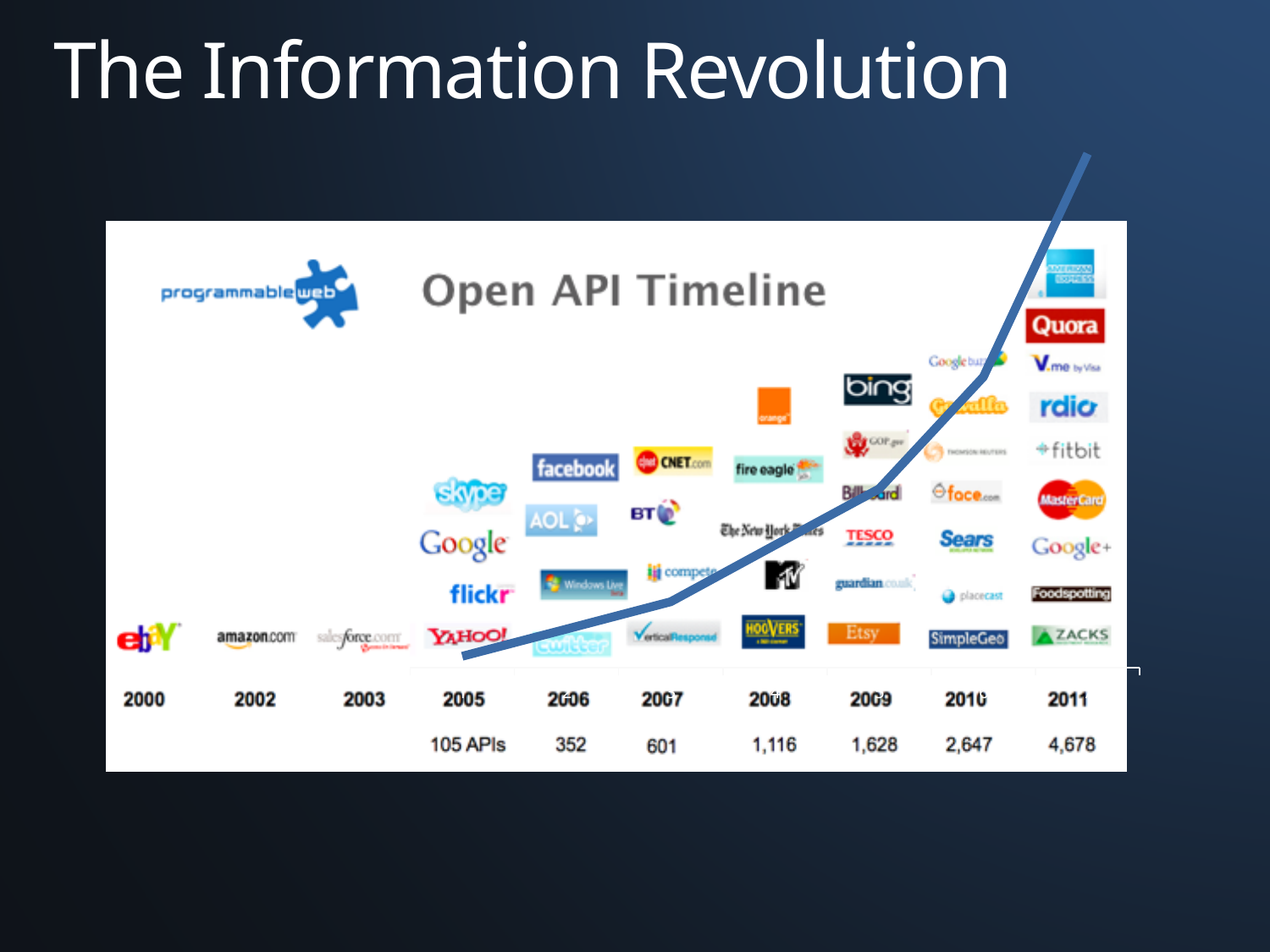
What is the title of the timeline graphic on the slide? Open API Timeline Which year has a larger API count, 2006 or 2007? 2007 Do the API counts rise or fall from 2005 to 2011 along the timeline? rise What is the difference between the API counts for 2009 and 2008? 512 According to the Open API Timeline, how many APIs are listed for 2011? 4,678 Among the years with an API count shown, which year has the lowest number of APIs? 2005 Which year on the Open API Timeline has the highest number of APIs? 2011 According to the Open API Timeline, how many APIs are listed for 2010? 2,647 According to the Open API Timeline, how many APIs are listed for 2008? 1,116 According to the Open API Timeline, how many APIs are listed for 2005? 105 APIs What is the difference between the API counts for 2011 and 2010? 2,031 How many years are labeled along the bottom of the Open API Timeline? 10